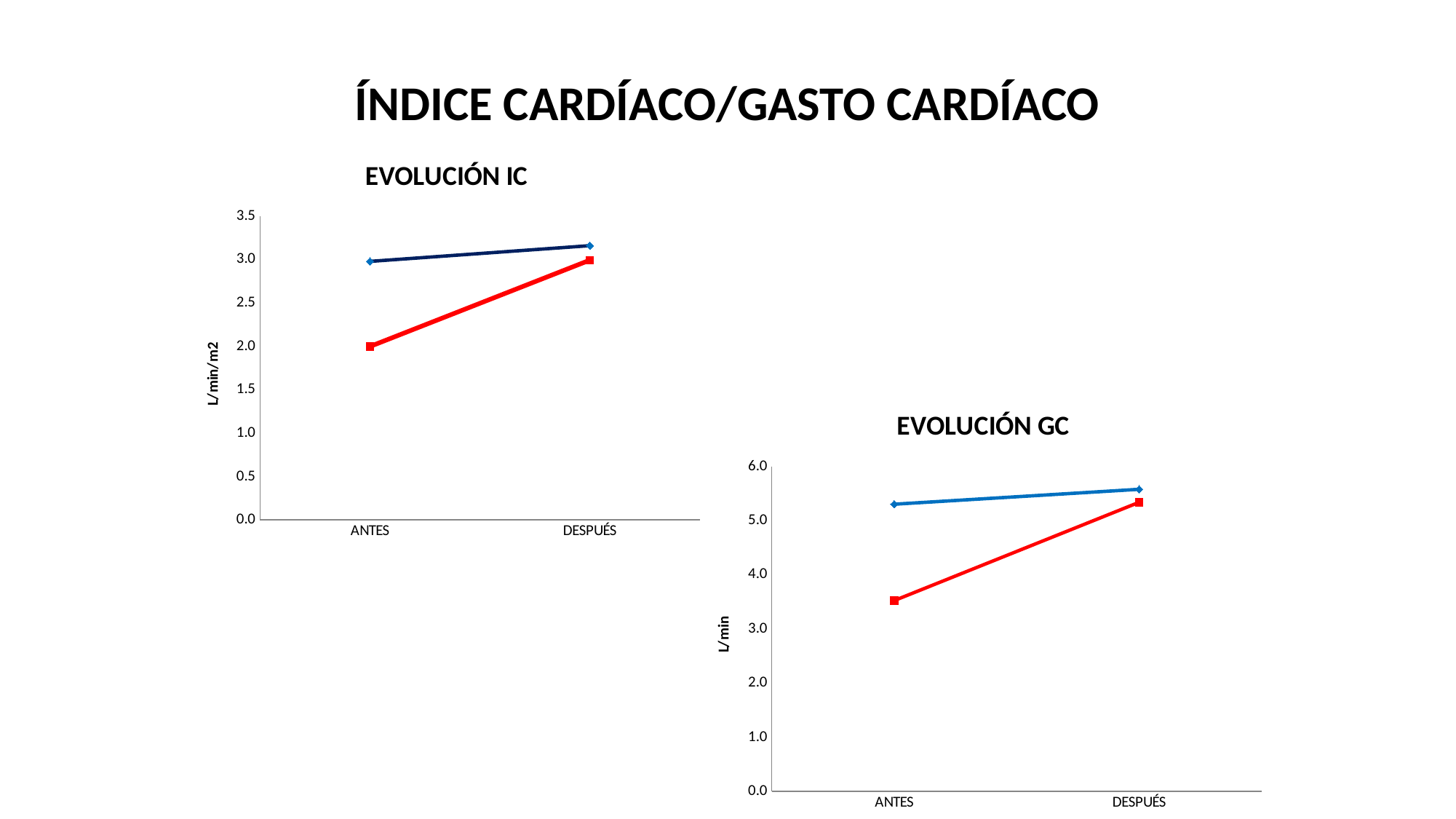
In the "EVOLUCIÓN GC" chart, which line has the higher value at ANTES, the blue line or the red line? The blue line What kind of chart is the "EVOLUCIÓN IC" chart? Line chart How many categories are shown on the x axis of the "EVOLUCIÓN GC" chart? 2 In the "EVOLUCIÓN IC" chart, is the red line's value at ANTES greater or less than 2.5? less What is the y-axis label of the "EVOLUCIÓN GC" chart? L/min In the "EVOLUCIÓN IC" chart, is the blue line's value at ANTES greater or less than 2.5? greater In the "EVOLUCIÓN IC" chart, which line has the higher value at ANTES, the blue line or the red line? The blue line What is the y-axis label of the "EVOLUCIÓN IC" chart? L/min/m2 In the "EVOLUCIÓN IC" chart, does the red line rise or fall from ANTES to DESPUÉS? Rise In the "EVOLUCIÓN GC" chart, is the blue line's value at ANTES greater or less than 5.0? greater In the "EVOLUCIÓN GC" chart, does the red line rise or fall from ANTES to DESPUÉS? Rise